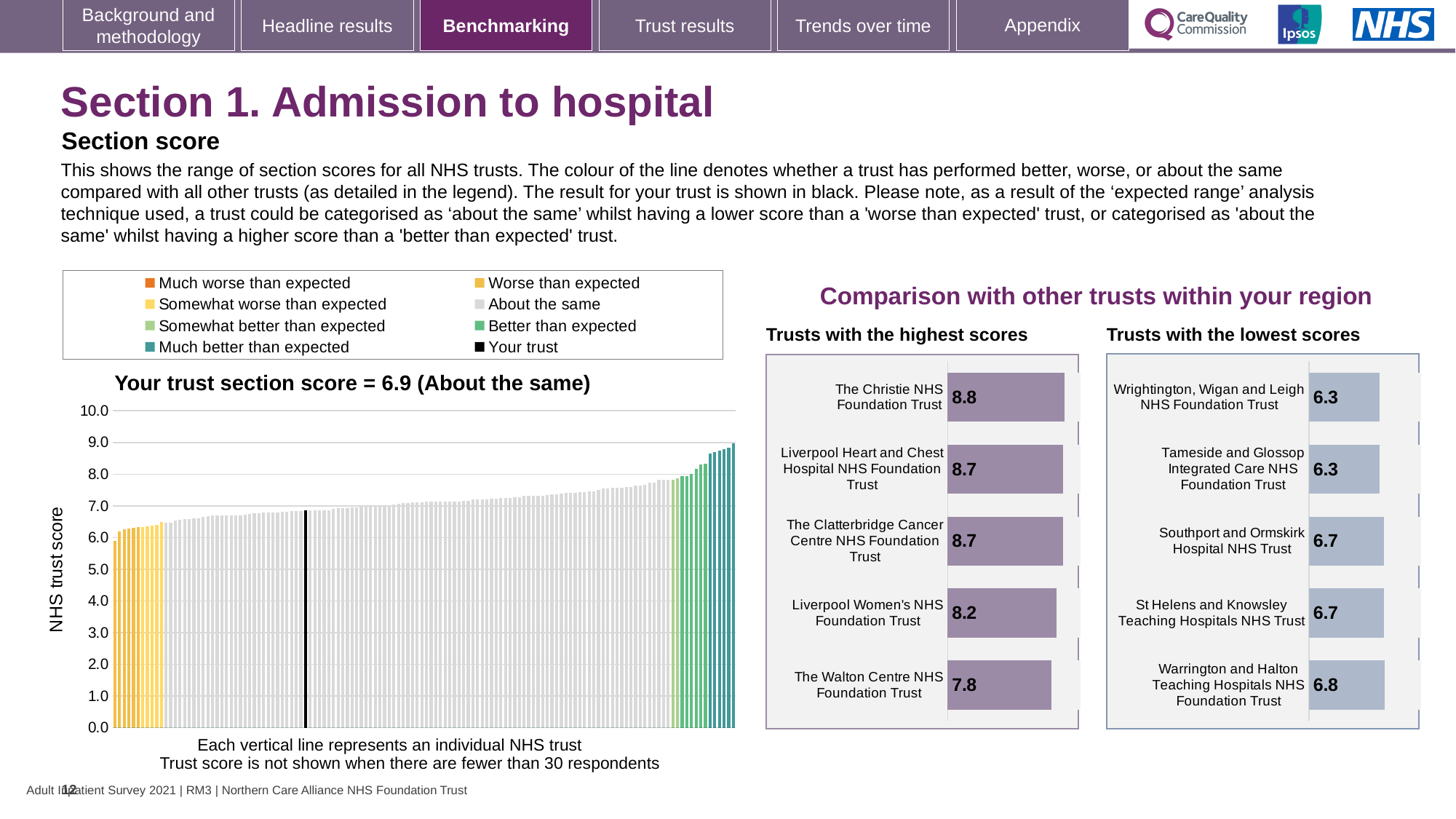
In the 'Trusts with the highest scores' chart, what is the difference between the scores of The Christie NHS Foundation Trust and The Walton Centre NHS Foundation Trust? 1.0 What is your trust's section score shown in the title of the 'Your trust section score' chart? 6.9 In the 'Trusts with the highest scores' chart, what is the score for The Christie NHS Foundation Trust? 8.8 In the 'Trusts with the lowest scores' chart, what is the score for Warrington and Halton Teaching Hospitals NHS Foundation Trust? 6.8 In the 'Trusts with the highest scores' chart, which trust has the lowest score? The Walton Centre NHS Foundation Trust How many trusts are shown in the 'Trusts with the lowest scores' chart? 5 In the 'Trusts with the lowest scores' chart, which has the larger score: Warrington and Halton Teaching Hospitals NHS Foundation Trust or Wrightington, Wigan and Leigh NHS Foundation Trust? Warrington and Halton Teaching Hospitals NHS Foundation Trust What kind of chart is the 'Your trust section score' chart? Bar chart In the 'Trusts with the lowest scores' chart, what is the score for Southport and Ormskirk Hospital NHS Trust? 6.7 In the 'Your trust section score' chart, do the trust scores rise or fall from left to right along the x axis? Rise In the 'Trusts with the highest scores' chart, which trust has the highest score? The Christie NHS Foundation Trust In the 'Trusts with the highest scores' chart, what is the score for The Walton Centre NHS Foundation Trust? 7.8